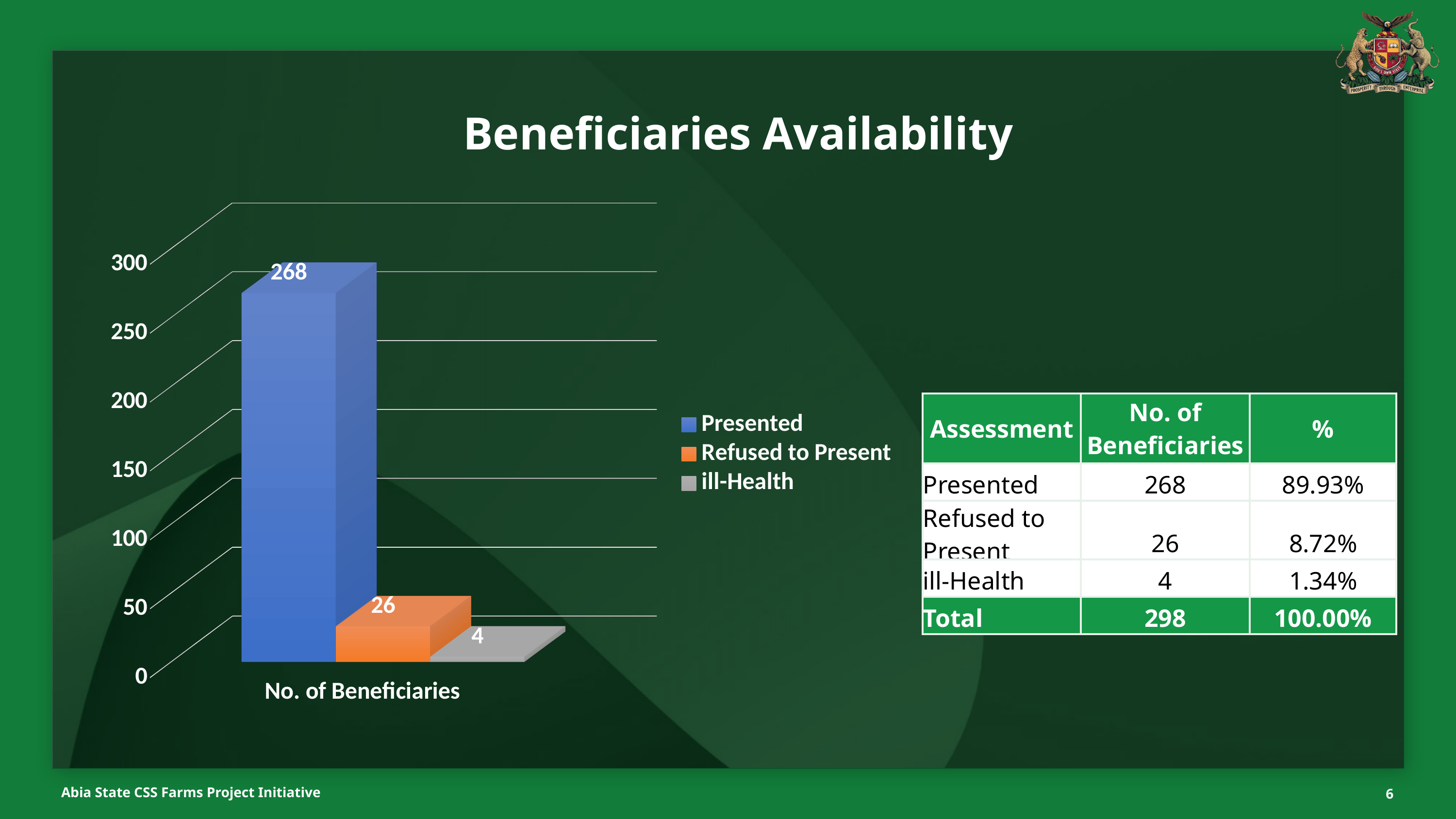
What is the value of the Refused to Present bar? 26 Which series has the highest value? Presented How many series does the legend list? 3 What kind of chart is shown on the slide? bar chart What is the difference between the Presented and Refused to Present values? 242 Is the value for Presented greater or less than 250? greater What is the difference between the Refused to Present and ill-Health values? 22 Which series has the lowest value? ill-Health What is the value of the Presented bar? 268 What is the value of the ill-Health bar? 4 Which is larger, Refused to Present or ill-Health? Refused to Present What is the title of the chart? Beneficiaries Availability